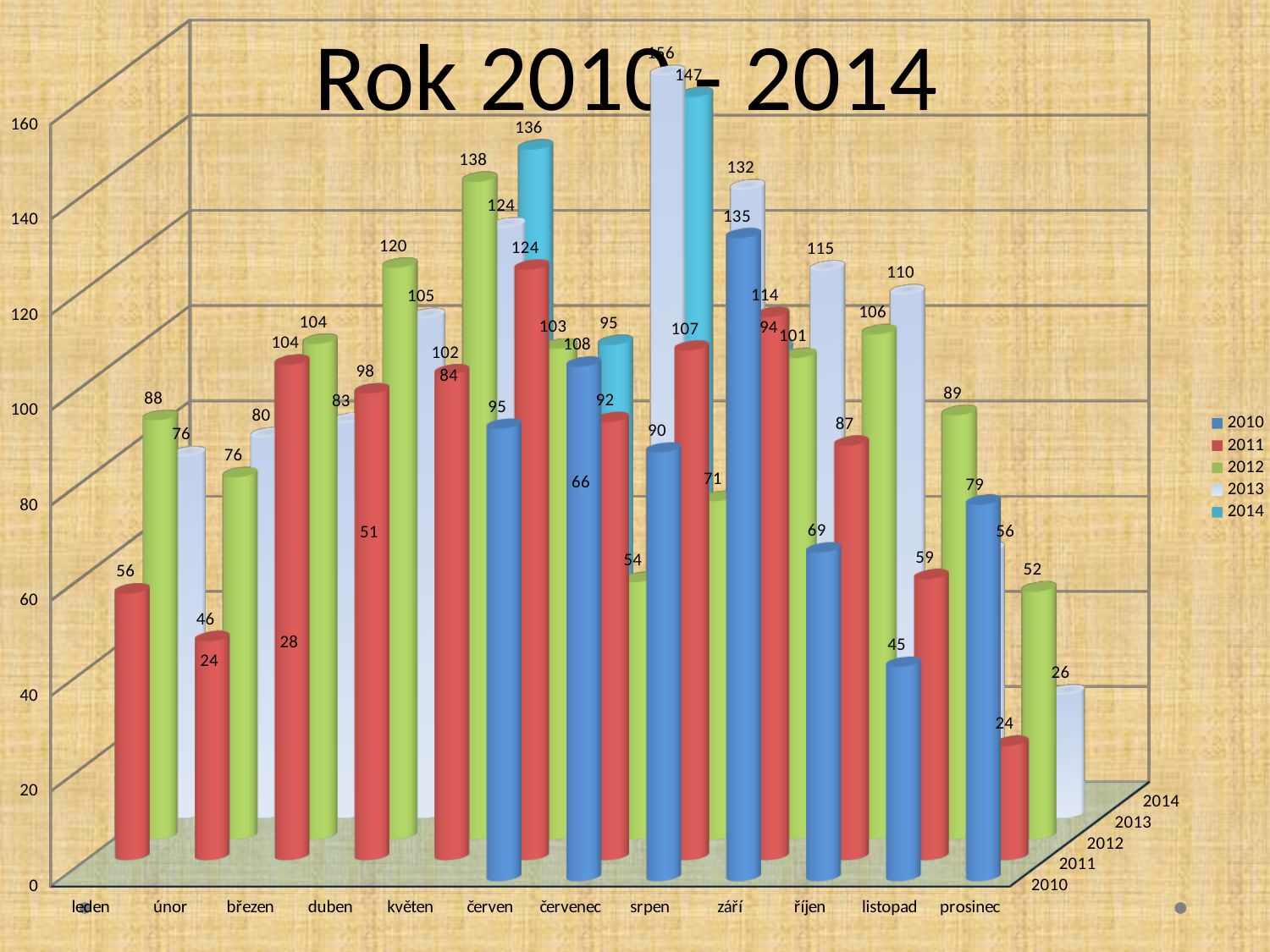
What is the value for 2011 in prosinec? 24 What is the value for 2011 in leden? 56 What is the value for 2010 in září? 135 What is the value for 2010 in listopad? 45 How many series does the legend list? 5 What is the title of the chart? Rok 2010 - 2014 How many month categories are shown on the x axis? 12 In which month is the 2010 series highest? září What is the value for 2012 in květen? 138 What kind of chart is shown on the slide? bar chart What is the difference between the 2010 values for září and listopad? 90 Which is larger for 2011: the value in leden or the value in prosinec? leden